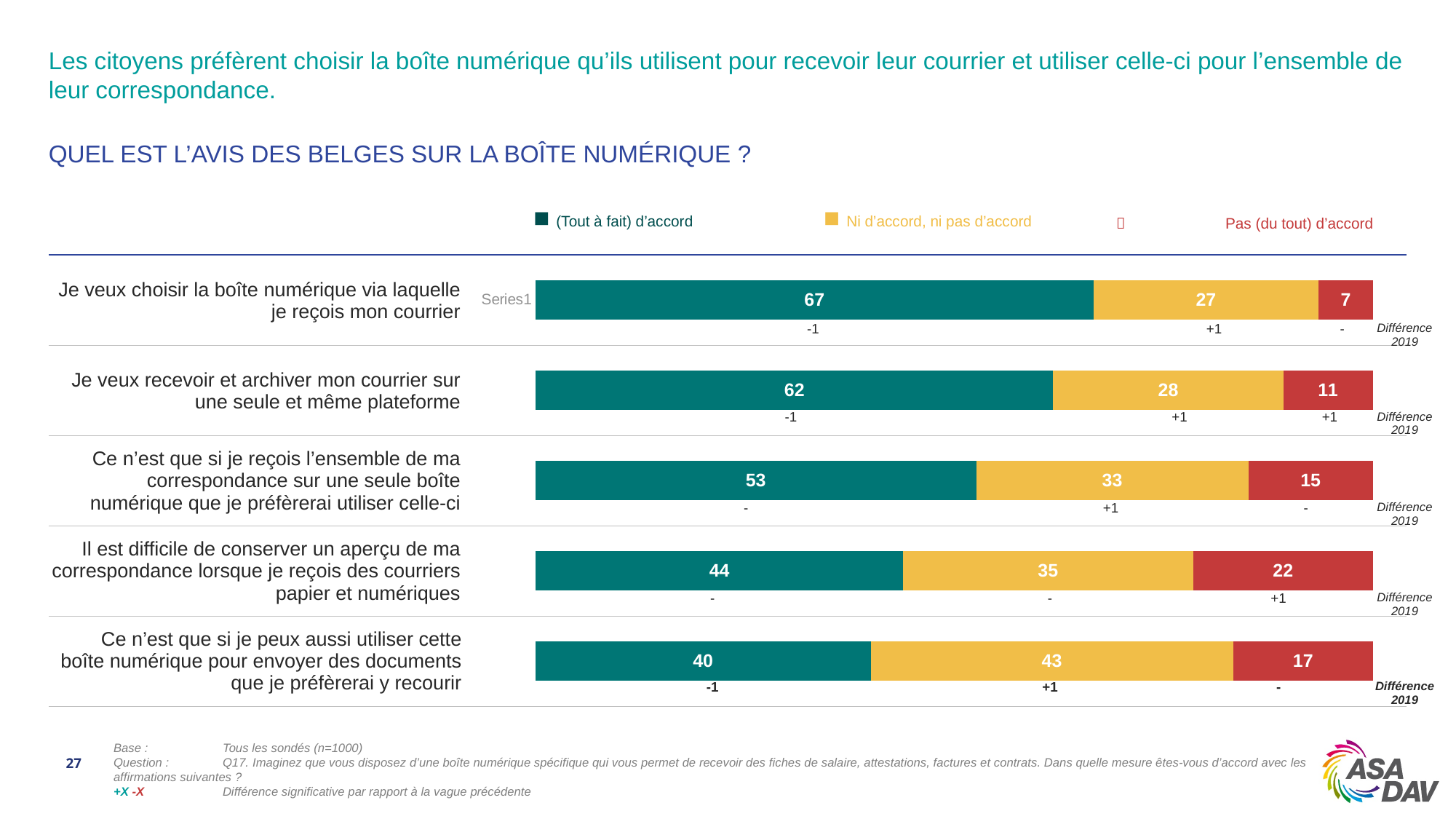
For the statement "Je veux choisir la boîte numérique via laquelle je reçois mon courrier", what is the value for "(Tout à fait) d'accord"? 67 What is the total of the stacked bar for "Ce n'est que si je peux aussi utiliser cette boîte numérique pour envoyer des documents que je préfèrerai y recourir"? 100 What kind of chart is used to show the results for each statement? Stacked bar chart How many series does the legend list? 3 Which statement has the lowest "Pas (du tout) d'accord" value? Je veux choisir la boîte numérique via laquelle je reçois mon courrier For the statement "Il est difficile de conserver un aperçu de ma correspondance lorsque je reçois des courriers papier et numériques", what is the value for "Ni d'accord, ni pas d'accord"? 35 For the statement "Ce n'est que si je peux aussi utiliser cette boîte numérique pour envoyer des documents que je préfèrerai y recourir", which is larger: "(Tout à fait) d'accord" or "Ni d'accord, ni pas d'accord"? Ni d'accord, ni pas d'accord Which statement has the highest "(Tout à fait) d'accord" value? Je veux choisir la boîte numérique via laquelle je reçois mon courrier What is the difference between the "(Tout à fait) d'accord" values for "Je veux choisir la boîte numérique via laquelle je reçois mon courrier" and "Je veux recevoir et archiver mon courrier sur une seule et même plateforme"? 5 For the statement "Je veux recevoir et archiver mon courrier sur une seule et même plateforme", what is the value for "Pas (du tout) d'accord"? 11 How many statements are shown on the slide? 5 For the statement "Il est difficile de conserver un aperçu de ma correspondance lorsque je reçois des courriers papier et numériques", what is the difference between "(Tout à fait) d'accord" and "Pas (du tout) d'accord"? 22